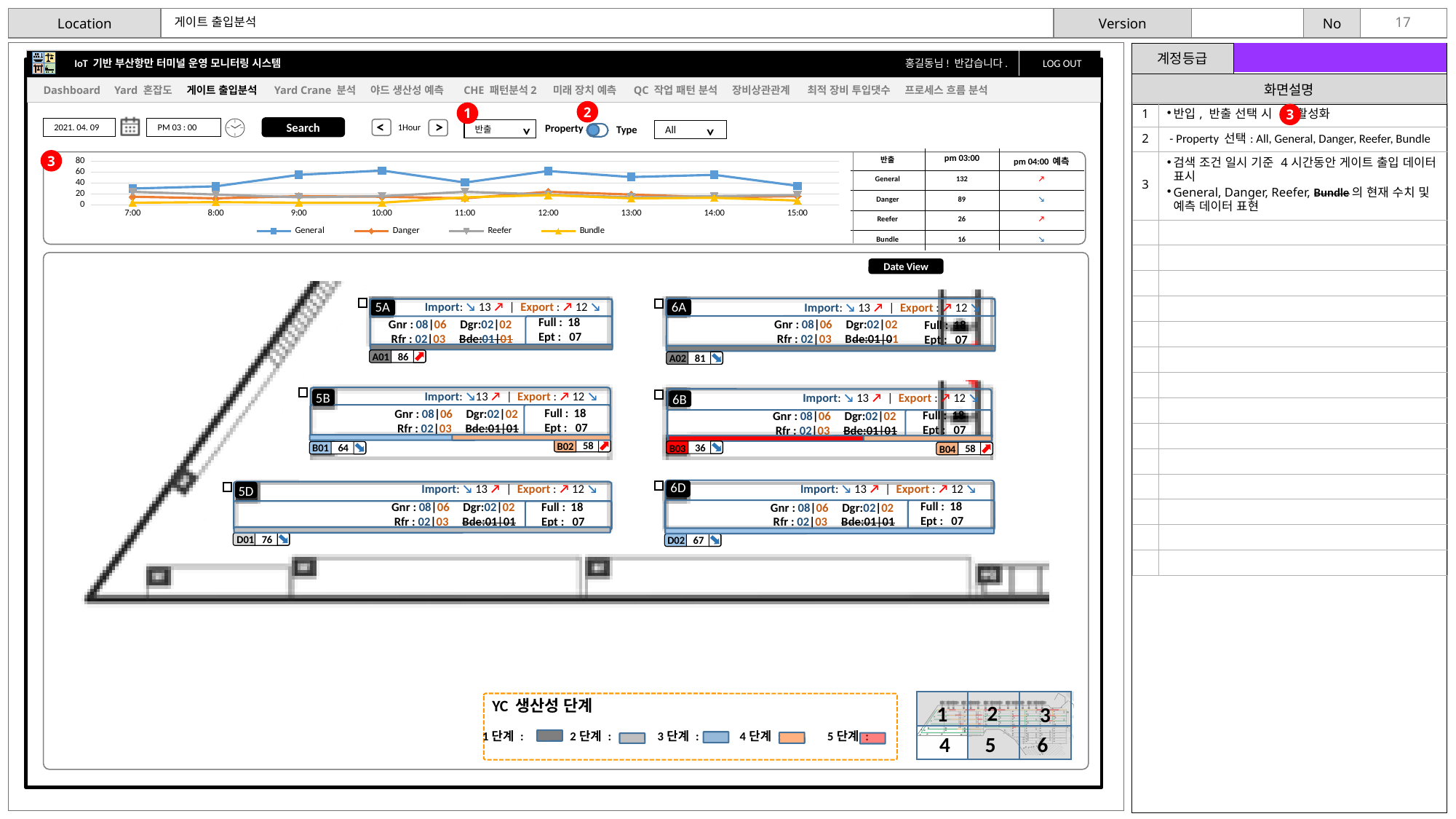
In the line chart, does the General series rise or fall from 7:00 to 10:00? rise In the line chart, is the value for General at 7:00 greater or less than 40? less What is the first time label on the x axis of the line chart? 7:00 Which series has the highest values across the line chart? General In the line chart, which is larger at 10:00: General or Bundle? General In the line chart, is the value for General at 10:00 greater or less than 40? greater How many time points are shown on the x axis of the line chart? 9 In the line chart, is the value for Danger at 12:00 greater or less than 40? less How many series does the legend of the line chart list? 4 What are the series names in the legend of the line chart? General, Danger, Reefer, Bundle What kind of chart is shown at the top of the slide? line chart